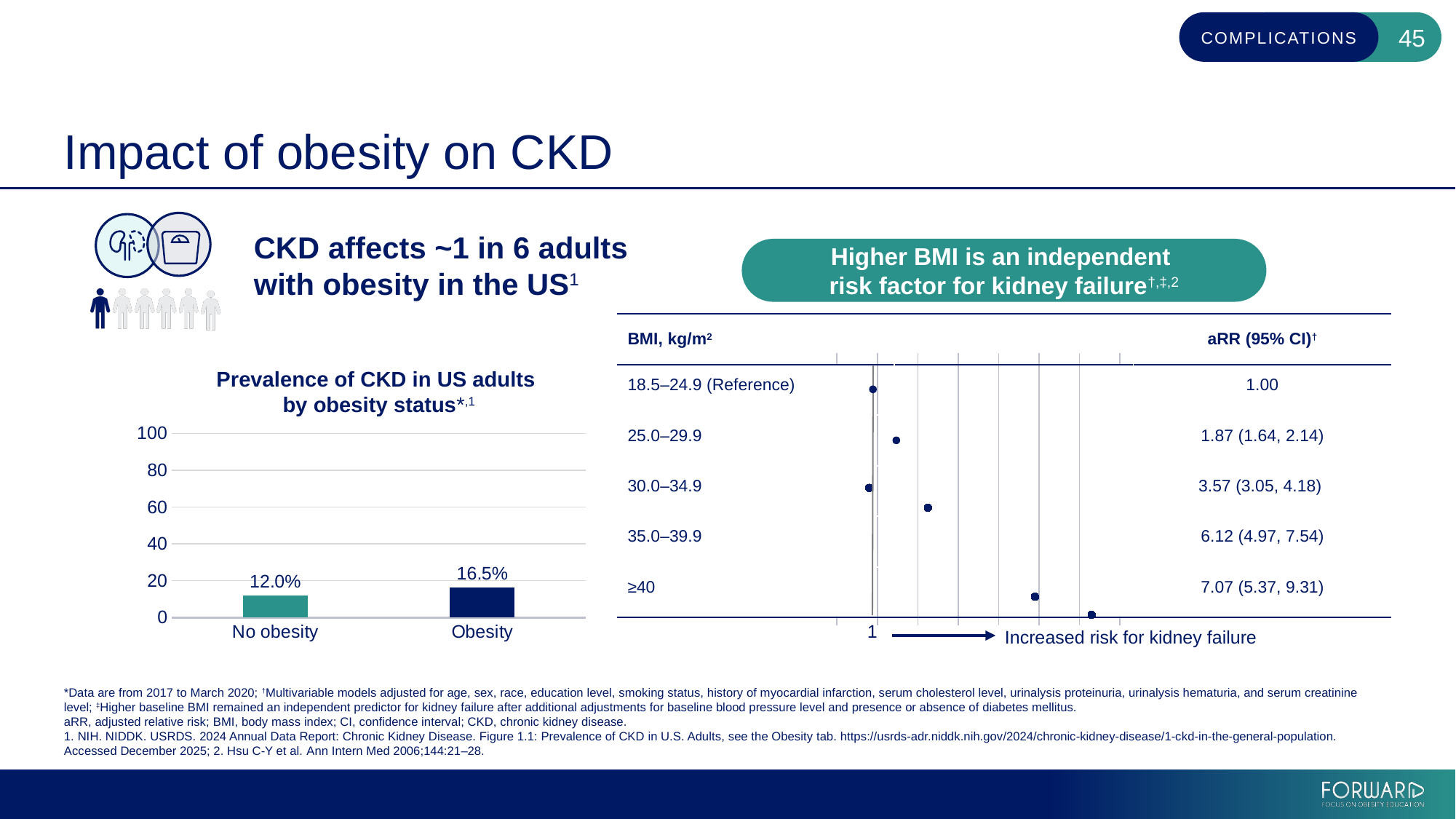
In the chart 'Prevalence of CKD in US adults by obesity status', how many categories are shown on the x axis? 2 In the chart 'Prevalence of CKD in US adults by obesity status', which category has the higher prevalence? Obesity In the chart 'Prevalence of CKD in US adults by obesity status', what is the value for Obesity? 16.5% In the forest plot on the right, what is the aRR (95% CI) for the BMI category 30.0–34.9? 3.57 (3.05, 4.18) What kind of chart is 'Prevalence of CKD in US adults by obesity status'? bar chart In the forest plot on the right, how many BMI categories are listed? 5 In the chart 'Prevalence of CKD in US adults by obesity status', what is the maximum value shown on the y axis? 100 In the forest plot on the right, which BMI category has the highest aRR? ≥40 In the chart 'Prevalence of CKD in US adults by obesity status', what is the difference between the Obesity and No obesity values? 4.5% In the chart 'Prevalence of CKD in US adults by obesity status', is the value for Obesity greater or less than 20? less In the chart 'Prevalence of CKD in US adults by obesity status', which category has the lower prevalence? No obesity In the chart 'Prevalence of CKD in US adults by obesity status', what is the value for No obesity? 12.0%